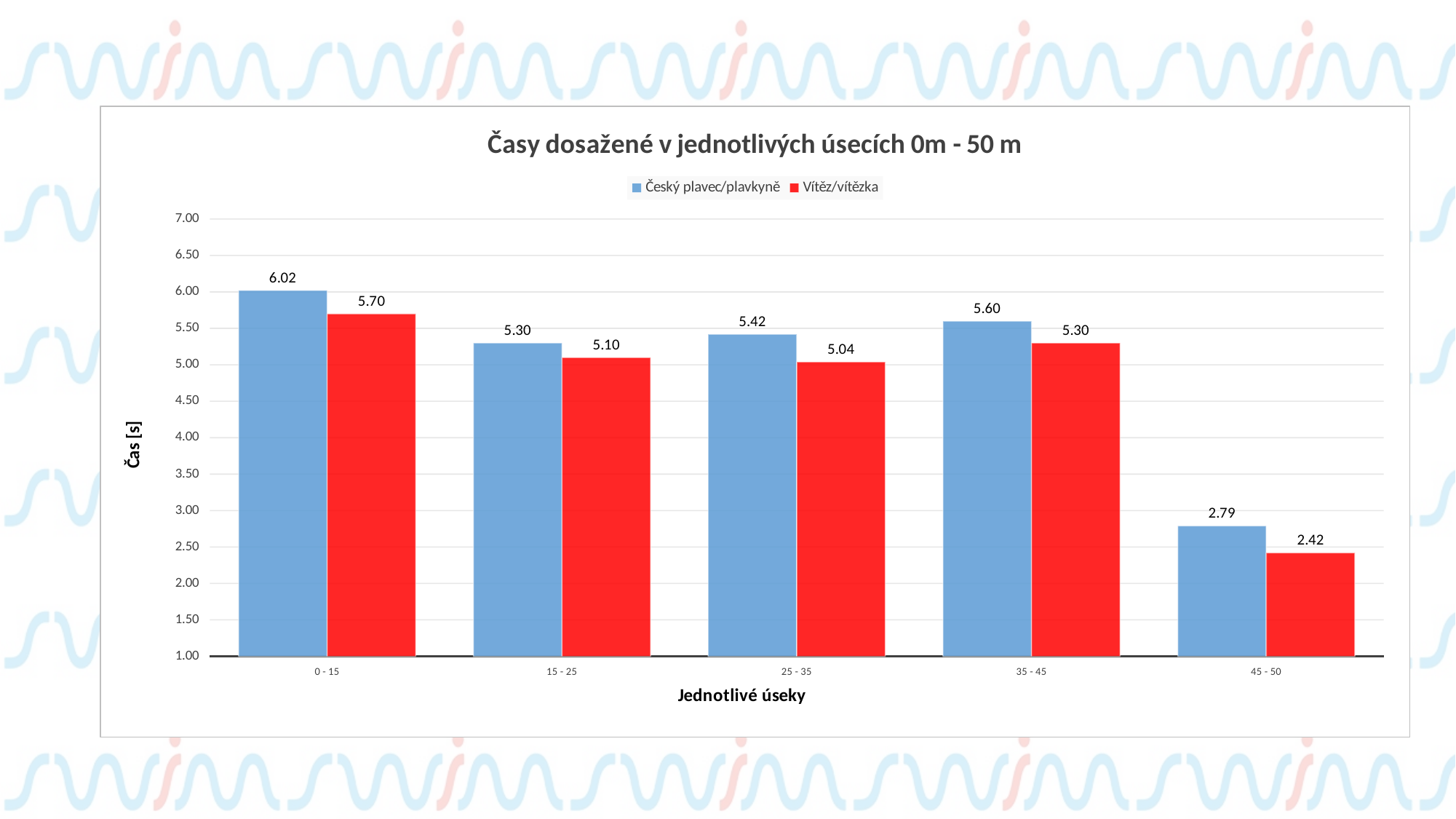
Which is larger in the 15 - 25 segment: Český plavec/plavkyně or Vítěz/vítězka? Český plavec/plavkyně Which segment has the highest value for Český plavec/plavkyně? 0 - 15 Which segment has the lowest value for Vítěz/vítězka? 45 - 50 What is the title of the chart? Časy dosažené v jednotlivých úsecích 0m - 50 m What is the label of the y axis? Čas [s] How many series does the legend list? 2 What is the value for Vítěz/vítězka in the 25 - 35 segment? 5.04 What kind of chart is shown on the slide? Bar chart What is the value for Vítěz/vítězka in the 45 - 50 segment? 2.42 What is the difference between Český plavec/plavkyně and Vítěz/vítězka in the 35 - 45 segment? 0.30 What is the value for Český plavec/plavkyně in the 0 - 15 segment? 6.02 How many segments are shown on the x axis? 5